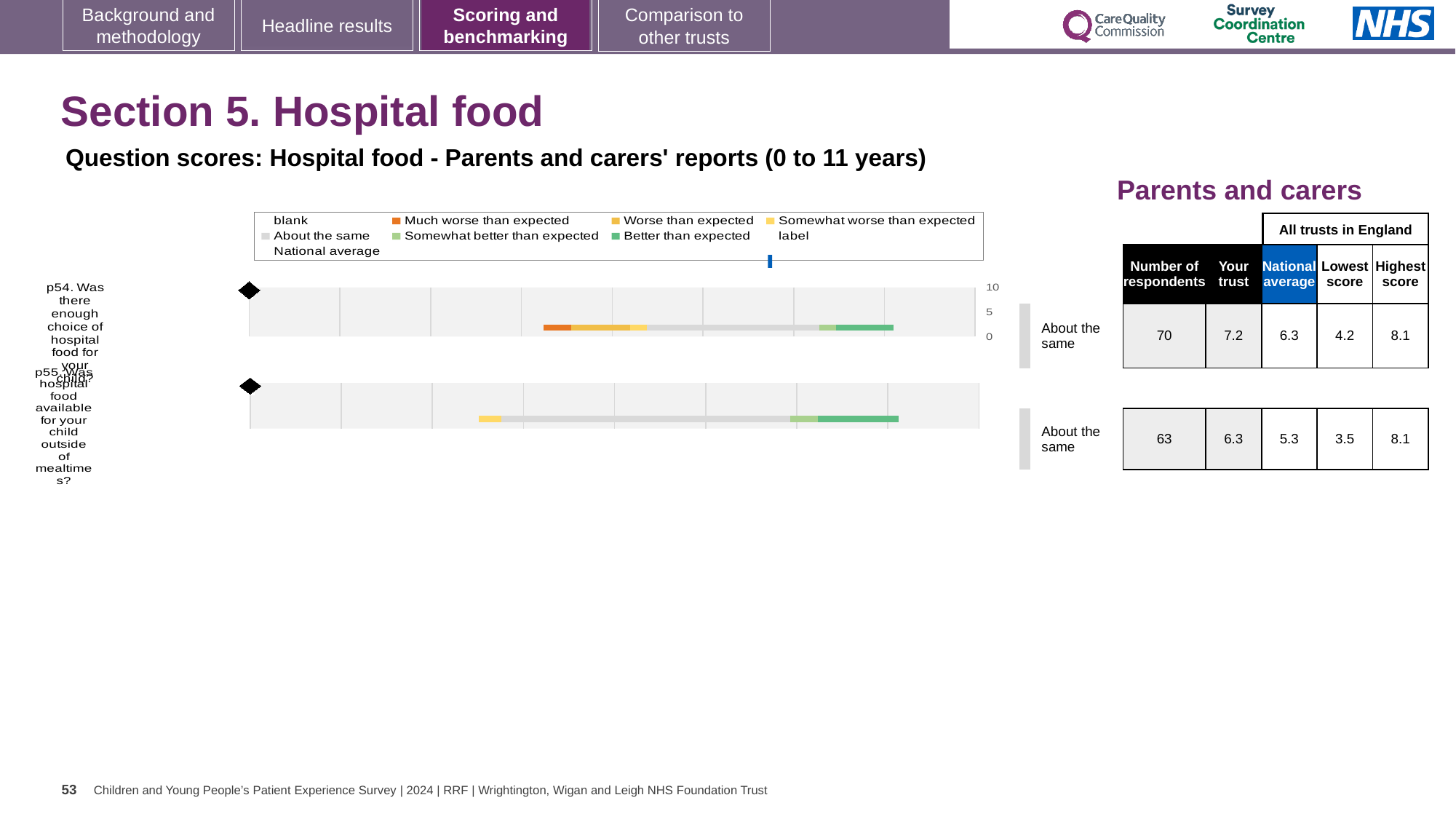
How many questions (bars) are plotted in the chart? 2 Which question has the higher 'Your trust' score, p54 or p55? p54 What colour does the legend use for 'Better than expected'? green What is the 'Your trust' score for p54 (enough choice of hospital food for your child)? 7.2 What is the lowest score across all trusts in England for p54? 4.2 How many respondents answered p54? 70 What is the difference between the 'Your trust' scores for p54 and p55? 0.9 How many entries does the chart legend list? 9 What is the national average for p55? 5.3 What kind of chart is shown on the slide? bar chart What is the 'Your trust' score for p55 (hospital food available outside of mealtimes)? 6.3 What colour does the legend use for 'Much worse than expected'? orange